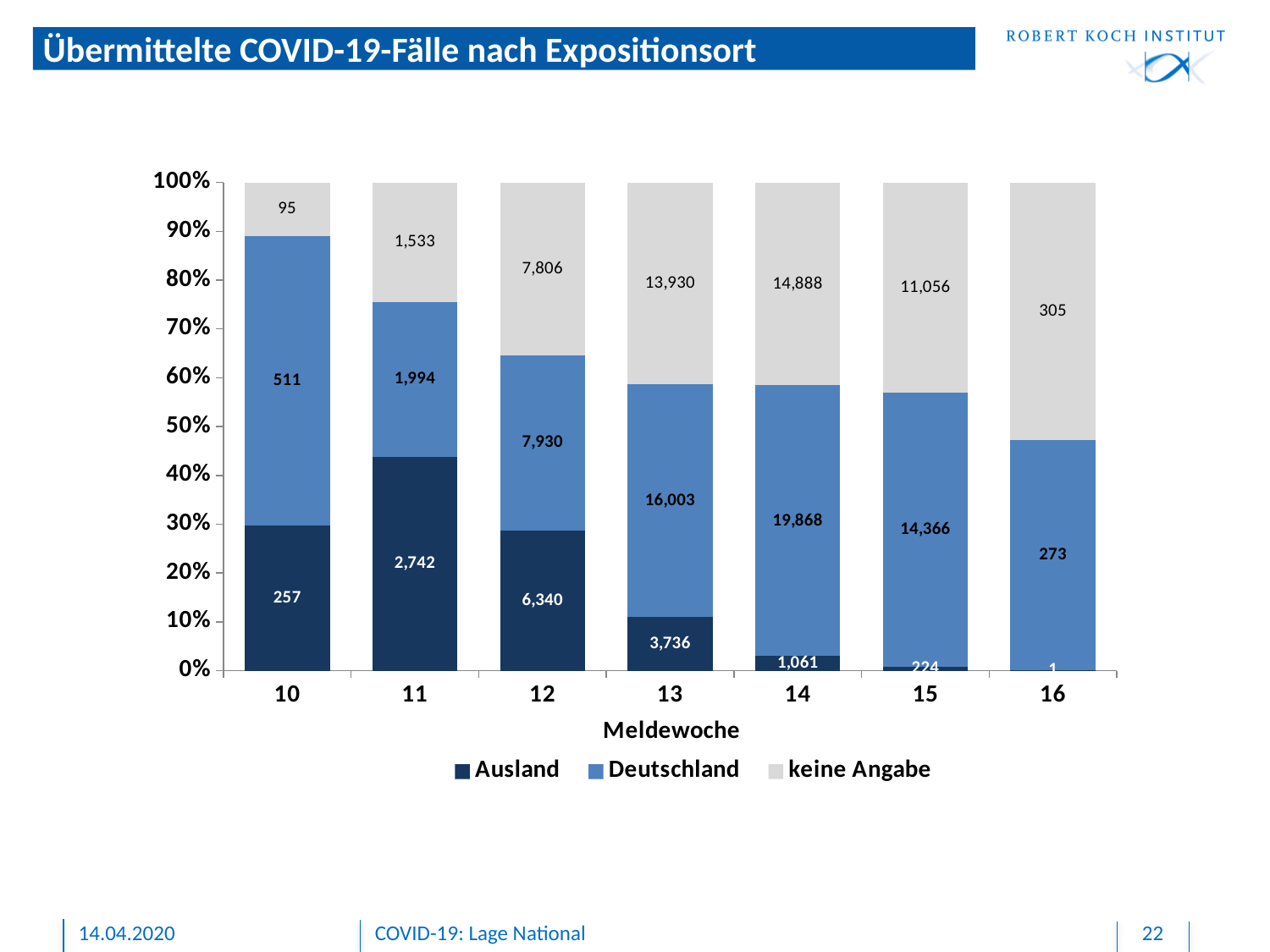
What kind of chart is shown on the slide? Stacked bar chart What is the value for Deutschland in Meldewoche 14? 19,868 What is the value for keine Angabe in Meldewoche 16? 305 What is the difference between the Deutschland value and the keine Angabe value in Meldewoche 13? 2,073 In Meldewoche 12, which is larger: the Deutschland value or the keine Angabe value? Deutschland Is the share of Ausland in Meldewoche 11 greater or less than 40%? greater How many Meldewochen are shown on the x axis? 7 What is the value for keine Angabe in Meldewoche 12? 7,806 In which Meldewoche is the Deutschland value the highest? 14 What is the total of the three labelled values in the bar for Meldewoche 10? 863 What is the value for Ausland in Meldewoche 11? 2,742 How many series does the legend list? 3